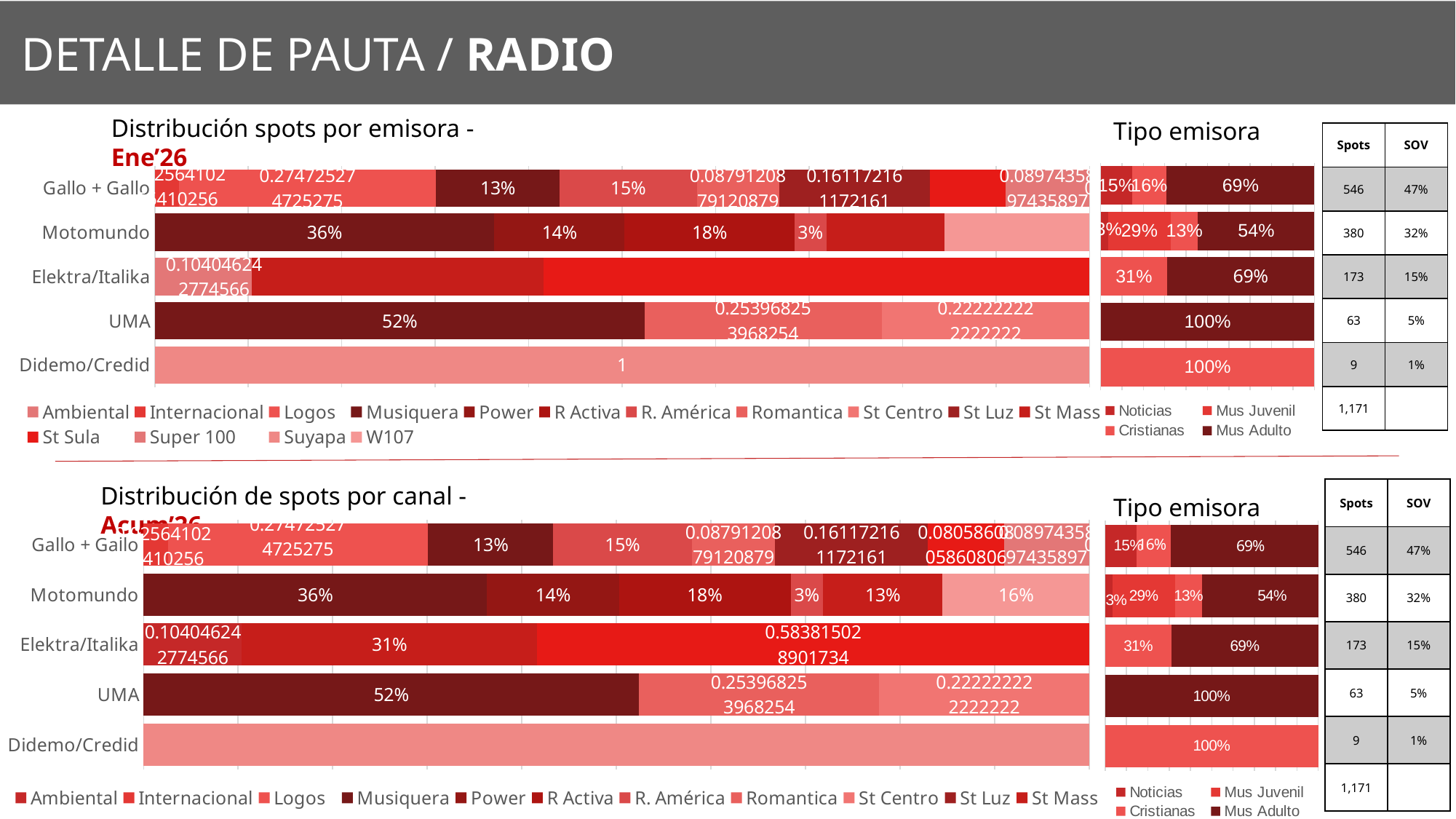
In the bottom-left chart 'Distribución de spots por canal - Acum'26', what is the value of the last (rightmost) segment of the Motomundo bar? 16% In the top-right chart 'Tipo emisora', what is the Mus Adulto value for Motomundo? 54% In the top-right chart 'Tipo emisora', what is the Mus Adulto value for Gallo + Gallo? 69% In the bottom-left chart 'Distribución de spots por canal - Acum'26', what is the difference between the 36% and 14% segments of the Motomundo bar? 22 percentage points In the top-left chart 'Distribución spots por emisora - Ene'26', what is the value of the largest segment in the UMA bar? 52% In the bottom-right chart 'Tipo emisora', what is the value shown for UMA? 100% How many series does the legend of the top-right chart 'Tipo emisora' list? 4 How many series does the legend of the top-left chart 'Distribución spots por emisora - Ene'26' list? 15 In the bottom-left chart 'Distribución de spots por canal - Acum'26', which is larger in the Motomundo bar: the first segment (36%) or the second segment (14%)? The first segment (36%) How many emisoras (categories) are shown on the y axis of the top-left chart 'Distribución spots por emisora - Ene'26'? 5 What kind of chart is the top-left chart titled 'Distribución spots por emisora - Ene'26'? Bar chart In the top-left chart 'Distribución spots por emisora - Ene'26', what is the value of the largest segment in the Motomundo bar? 36%